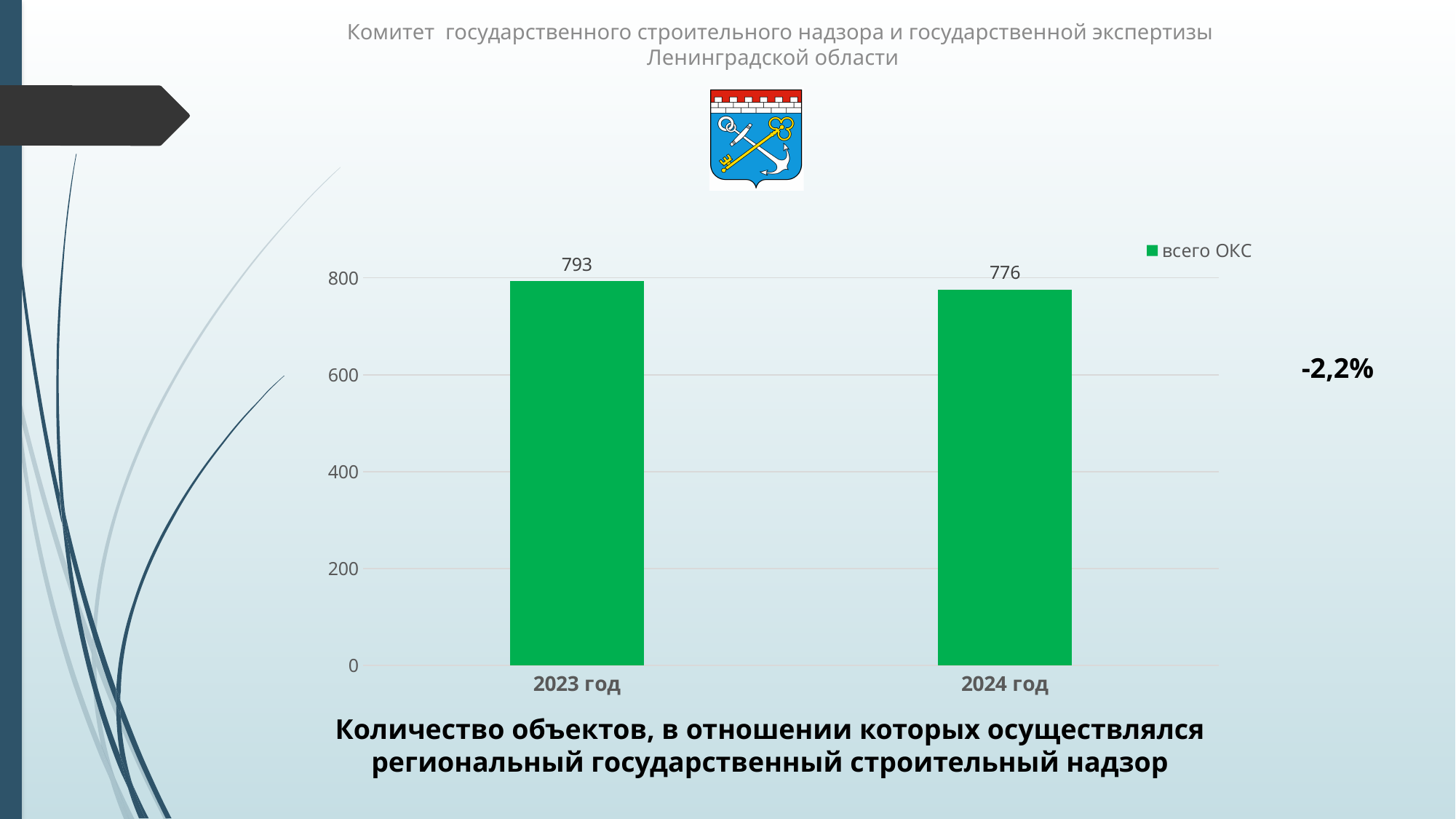
Which year has the lowest value? 2024 год What is the value for 2023 год? 793 How many categories are shown on the x axis? 2 Is the value for 2024 год greater or less than 600? greater What is the difference between the values for 2023 год and 2024 год? 17 What is the value for 2024 год? 776 Which year has the highest value? 2023 год What kind of chart is shown on the slide? bar chart How many series does the legend list? 1 Do the values rise or fall from 2023 год to 2024 год? fall What is the name of the series in the legend? всего ОКС Which is larger, the value for 2023 год or for 2024 год? 2023 год